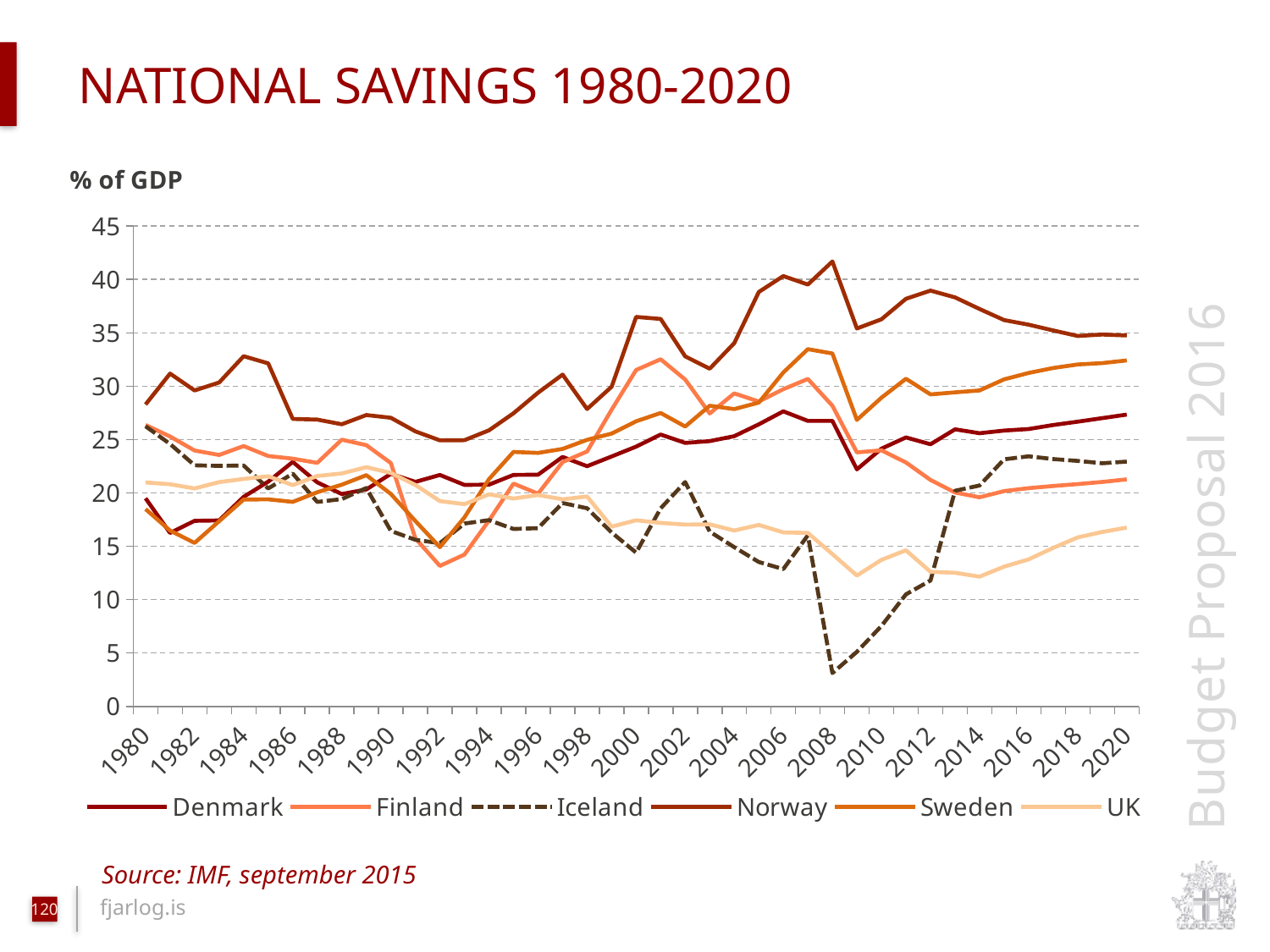
How many countries does the legend list? 6 In 2020, which is larger: the value for Sweden or the value for Finland? Sweden Is the value for UK in 2020 greater or less than 20? less Which country has the lowest national savings in 2020? UK Which country has the highest national savings in 2008? Norway Does the value for Norway rise or fall from 2008 to 2020? fall Which country has the lowest national savings in 2009? Iceland Is the value for Sweden in 2020 greater or less than 30? greater Is the value for Norway in 2008 greater or less than 40? greater What kind of chart is shown on the slide? line chart What unit is shown on the y axis label of the chart? % of GDP